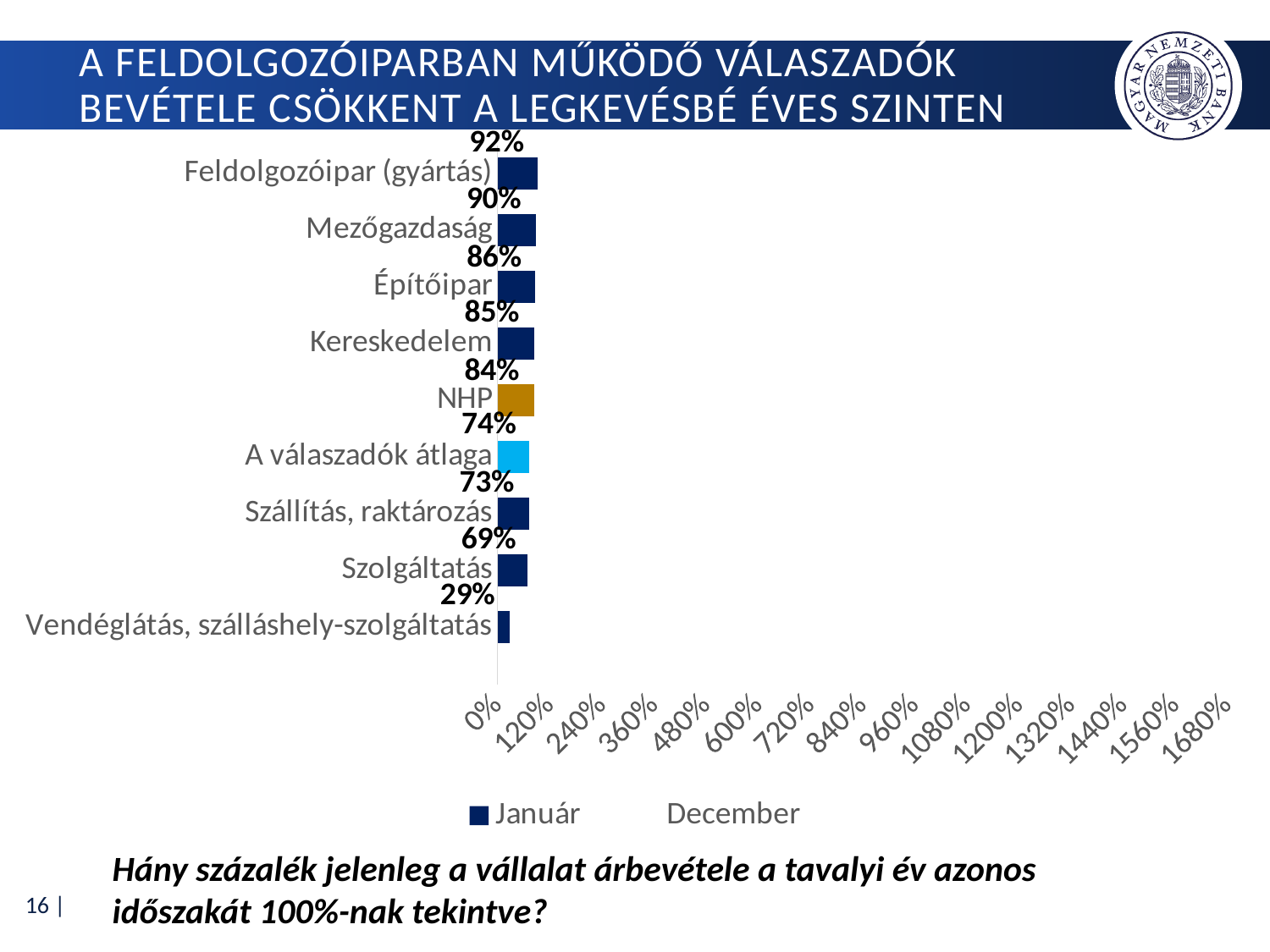
How many categories are shown on the chart? 9 Which is larger, the value for Építőipar or the value for Szállítás, raktározás? Építőipar What kind of chart is shown on the slide? Bar chart How many series does the legend list? 2 Which category has the lowest value? Vendéglátás, szálláshely-szolgáltatás Which category has the highest value? Feldolgozóipar (gyártás) What value is shown for Feldolgozóipar (gyártás)? 92% What value is shown for A válaszadók átlaga? 74% What value is shown for NHP? 84% What are the two series named in the legend? Január and December What is the difference between the values for Mezőgazdaság and Szolgáltatás? 21% What value is shown for Vendéglátás, szálláshely-szolgáltatás? 29%